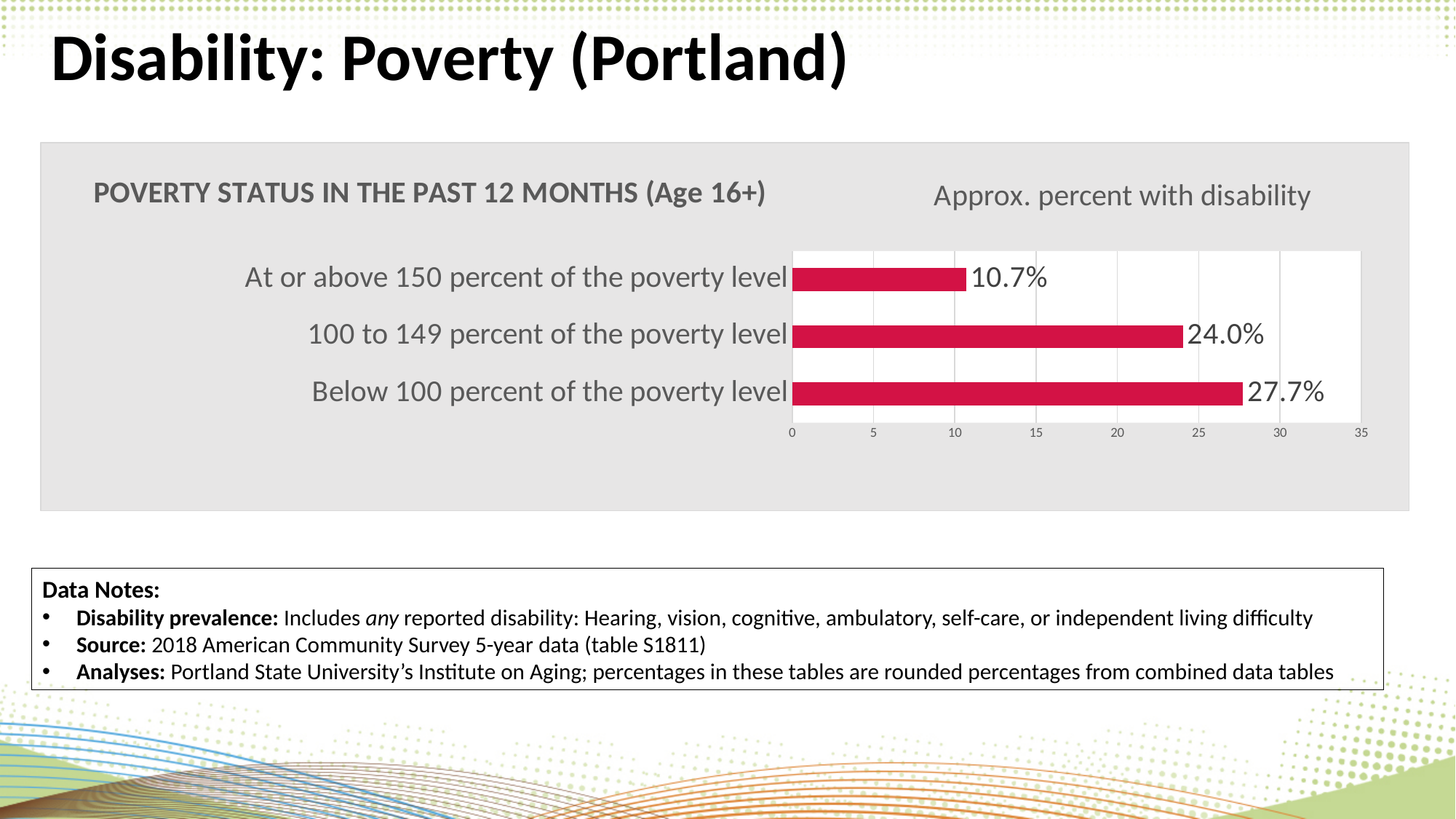
Is the value for 100 to 149 percent of the poverty level greater or less than 20? greater What is the title of the chart? POVERTY STATUS IN THE PAST 12 MONTHS (Age 16+) What is the difference in percent with disability between those below 100 percent and those 100 to 149 percent of the poverty level? 3.7% How many poverty status categories are shown in the chart? 3 What is the difference in percent with disability between those below 100 percent of the poverty level and those at or above 150 percent of the poverty level? 17.0% Which poverty status category has the lowest percent with disability? At or above 150 percent of the poverty level What is the approximate percent with disability for people below 100 percent of the poverty level? 27.7% Which has a higher percent with disability: 100 to 149 percent of the poverty level or at or above 150 percent of the poverty level? 100 to 149 percent of the poverty level Which poverty status category has the highest percent with disability? Below 100 percent of the poverty level What kind of chart is shown on the slide? Bar chart What is the approximate percent with disability for people 100 to 149 percent of the poverty level? 24.0% What is the approximate percent with disability for people at or above 150 percent of the poverty level? 10.7%